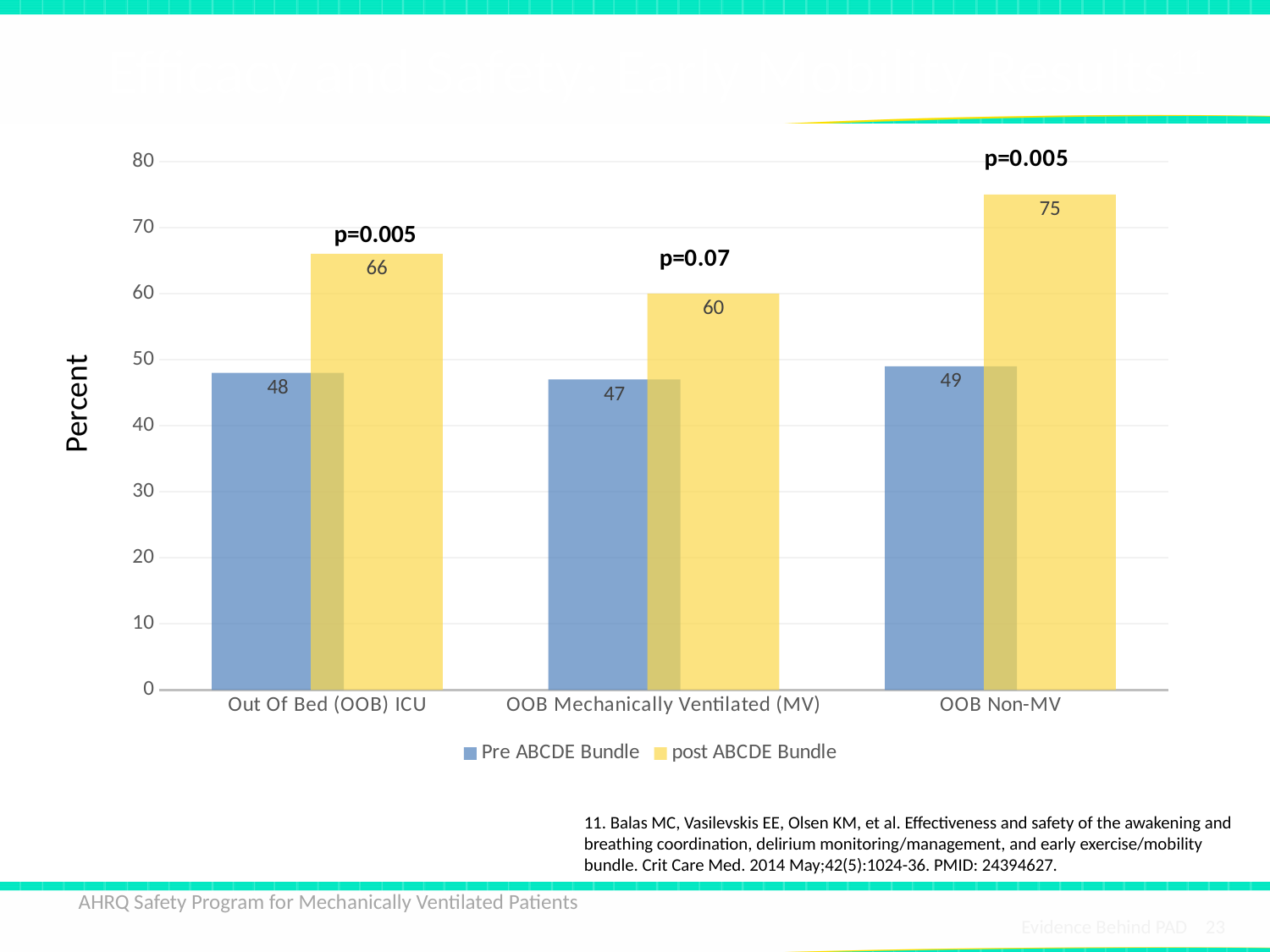
Which category has the lowest Pre ABCDE Bundle value? OOB Mechanically Ventilated (MV) What is the post ABCDE Bundle value for OOB Non-MV? 75 What is the difference between the post and Pre ABCDE Bundle values for OOB Non-MV? 26 How many series does the legend list? 2 How many categories are shown on the x axis? 3 Which is larger for OOB Mechanically Ventilated (MV): the Pre ABCDE Bundle value or the post ABCDE Bundle value? post ABCDE Bundle What kind of chart is shown on the slide? bar chart Which category has the highest post ABCDE Bundle value? OOB Non-MV What is the label on the y axis? Percent What is the Pre ABCDE Bundle value for Out Of Bed (OOB) ICU? 48 What is the difference between the post and Pre ABCDE Bundle values for Out Of Bed (OOB) ICU? 18 What is the post ABCDE Bundle value for OOB Mechanically Ventilated (MV)? 60